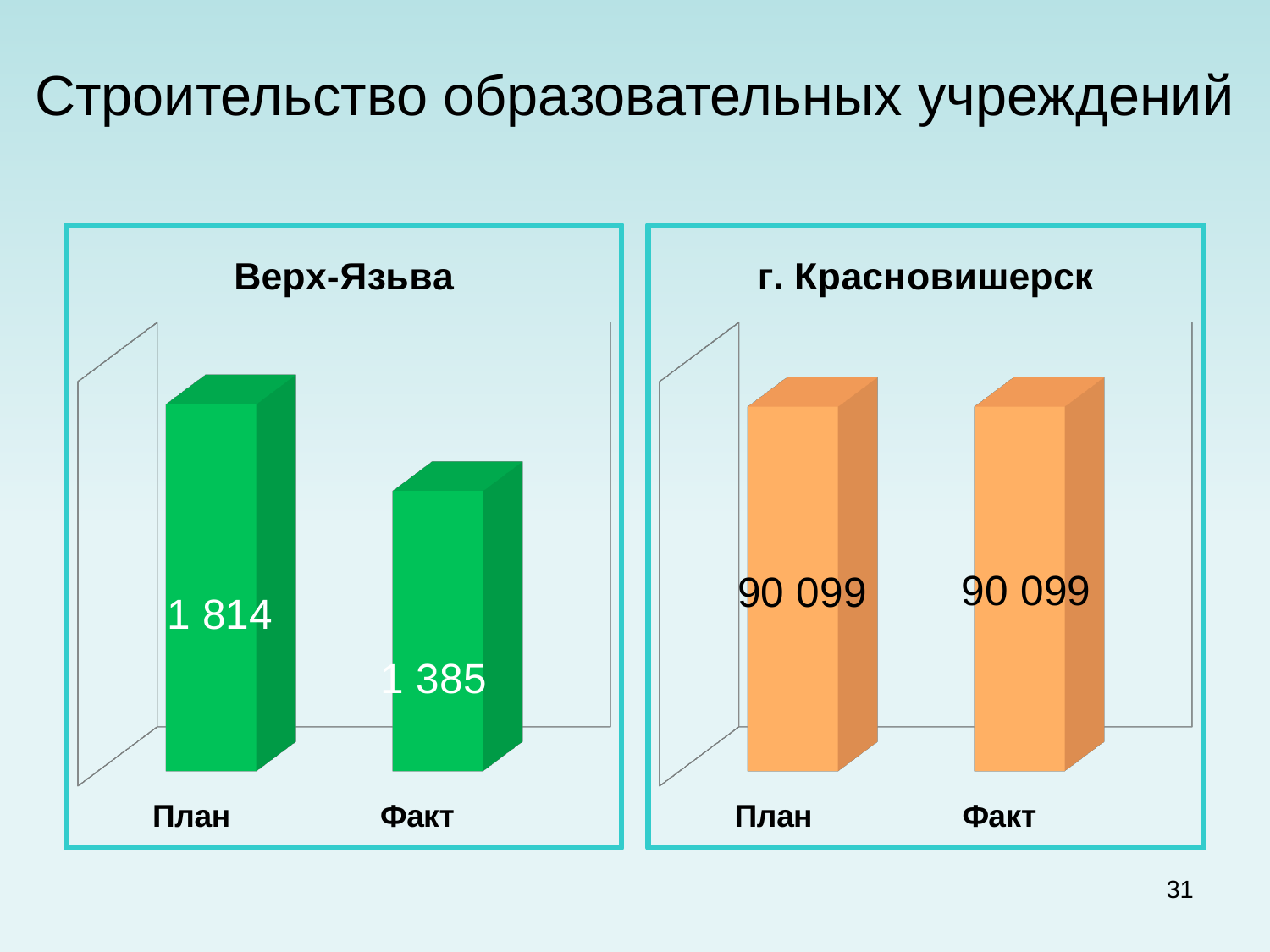
What kind of chart is the г. Красновишерск chart? Bar chart What colour are the bars in the г. Красновишерск chart? Orange In the г. Красновишерск chart, what is the value for План? 90 099 In the г. Красновишерск chart, what is the value for Факт? 90 099 In the Верх-Язьва chart, which category has the lowest value? Факт In the Верх-Язьва chart, what is the value for Факт? 1 385 What is the title of the left chart? Верх-Язьва In the Верх-Язьва chart, which category has the higher value, План or Факт? План How many categories are shown in the Верх-Язьва chart? 2 In the Верх-Язьва chart, what is the difference between План and Факт? 429 In the г. Красновишерск chart, what is the difference between План and Факт? 0 In the Верх-Язьва chart, what is the value for План? 1 814